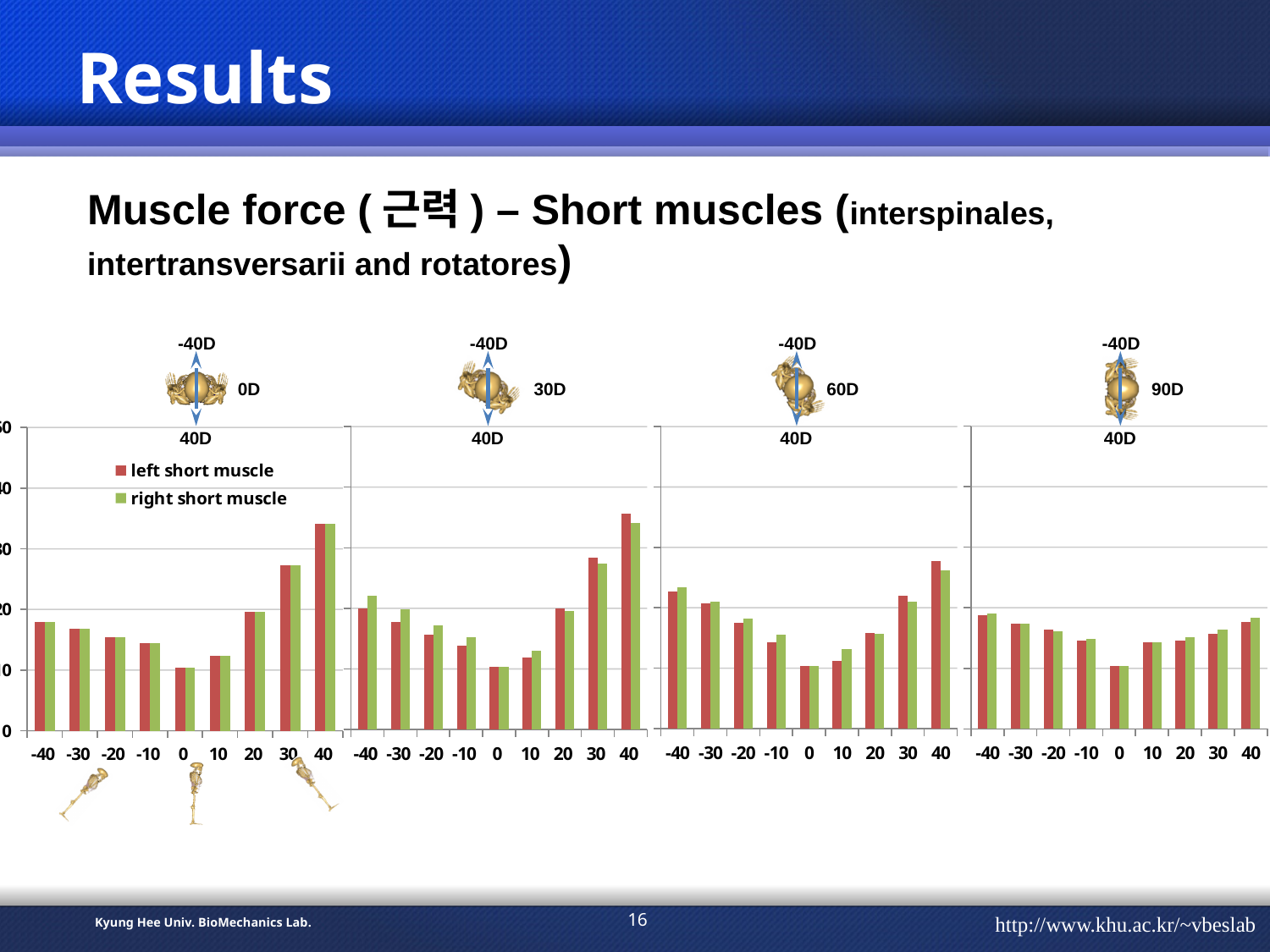
How many x-axis categories does the 0D chart have? 9 In the 0D chart, do the left short muscle bars rise or fall from x = 0 to x = 40? rise In the 0D chart, is the left short muscle bar larger at -40 or at 40? 40 What are the two series named in the legend? left short muscle and right short muscle How many series does the legend list? 2 In the 60D chart, at which x-axis value is the left short muscle bar highest? 40 In the 0D chart, at which x-axis value is the left short muscle bar lowest? 0 In the 0D chart, at which x-axis value is the left short muscle bar highest? 40 In the 30D chart, at which x-axis value is the right short muscle bar highest? 40 What kind of chart is used in the 0D panel? bar chart In the 90D chart, at which x-axis value is the right short muscle bar lowest? 0 In the 30D chart, at which x-axis value is the left short muscle bar lowest? 0